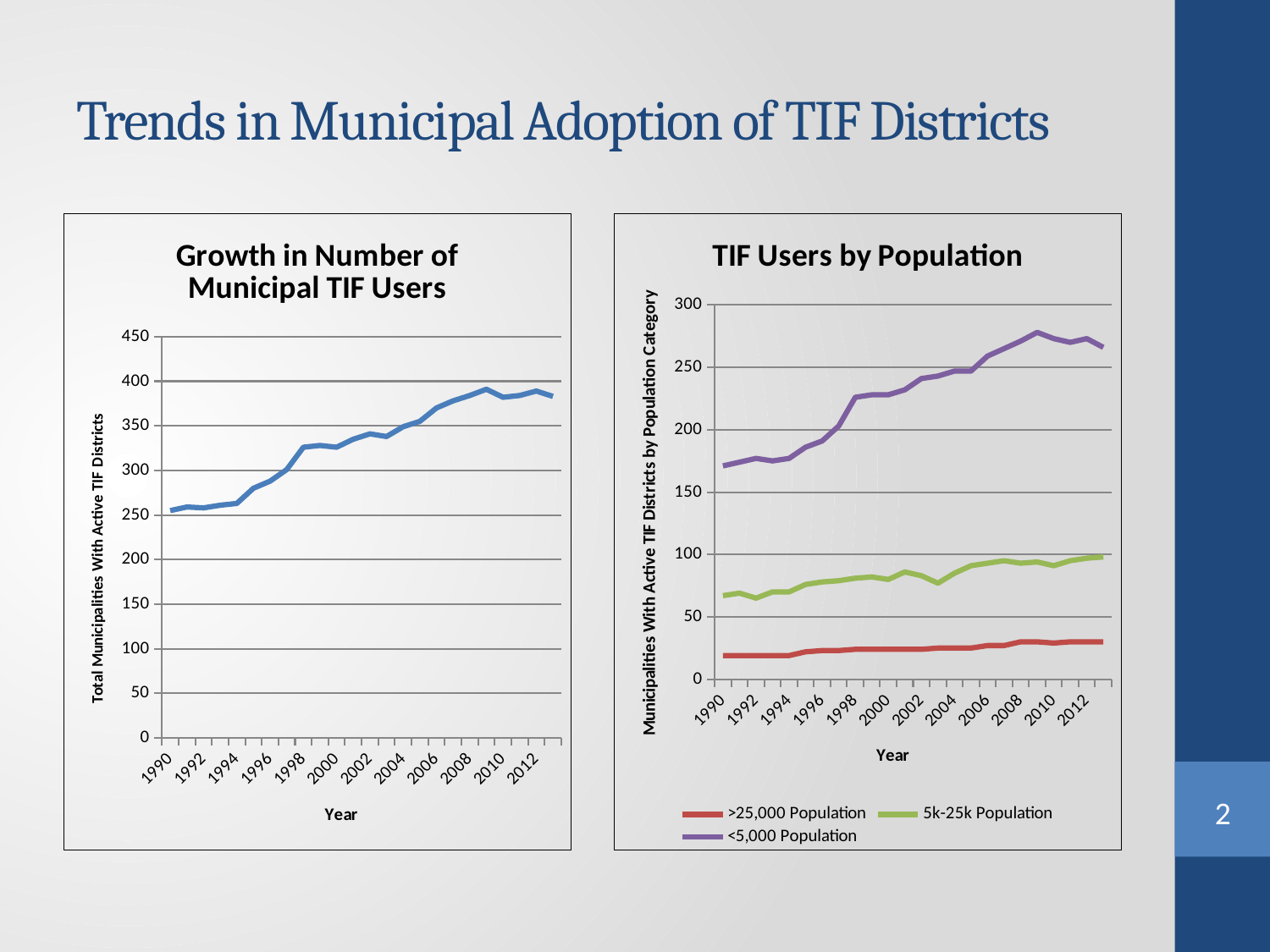
In the 'TIF Users by Population' chart, is the value for <5,000 Population in 1990 greater or less than 150? greater In the 'Growth in Number of Municipal TIF Users' chart, do the values generally rise or fall from 1990 to 2012? rise How many series does the legend of the 'TIF Users by Population' chart list? 3 In the 'TIF Users by Population' chart, is the value for >25,000 Population in 2012 greater or less than 50? less In the 'Growth in Number of Municipal TIF Users' chart, is the value for 2012 greater or less than 350? greater What kind of chart is the 'Growth in Number of Municipal TIF Users' chart on the left? line chart In the 'TIF Users by Population' chart, which population category has the lowest values throughout the period? >25,000 Population In the 'TIF Users by Population' chart, what colour is the line for <5,000 Population? purple What is the y-axis title of the 'Growth in Number of Municipal TIF Users' chart? Total Municipalities With Active TIF Districts In the 'TIF Users by Population' chart, which population category has the highest values throughout the period? <5,000 Population In the 'TIF Users by Population' chart, does the <5,000 Population line generally rise or fall from 1990 to 2012? rise